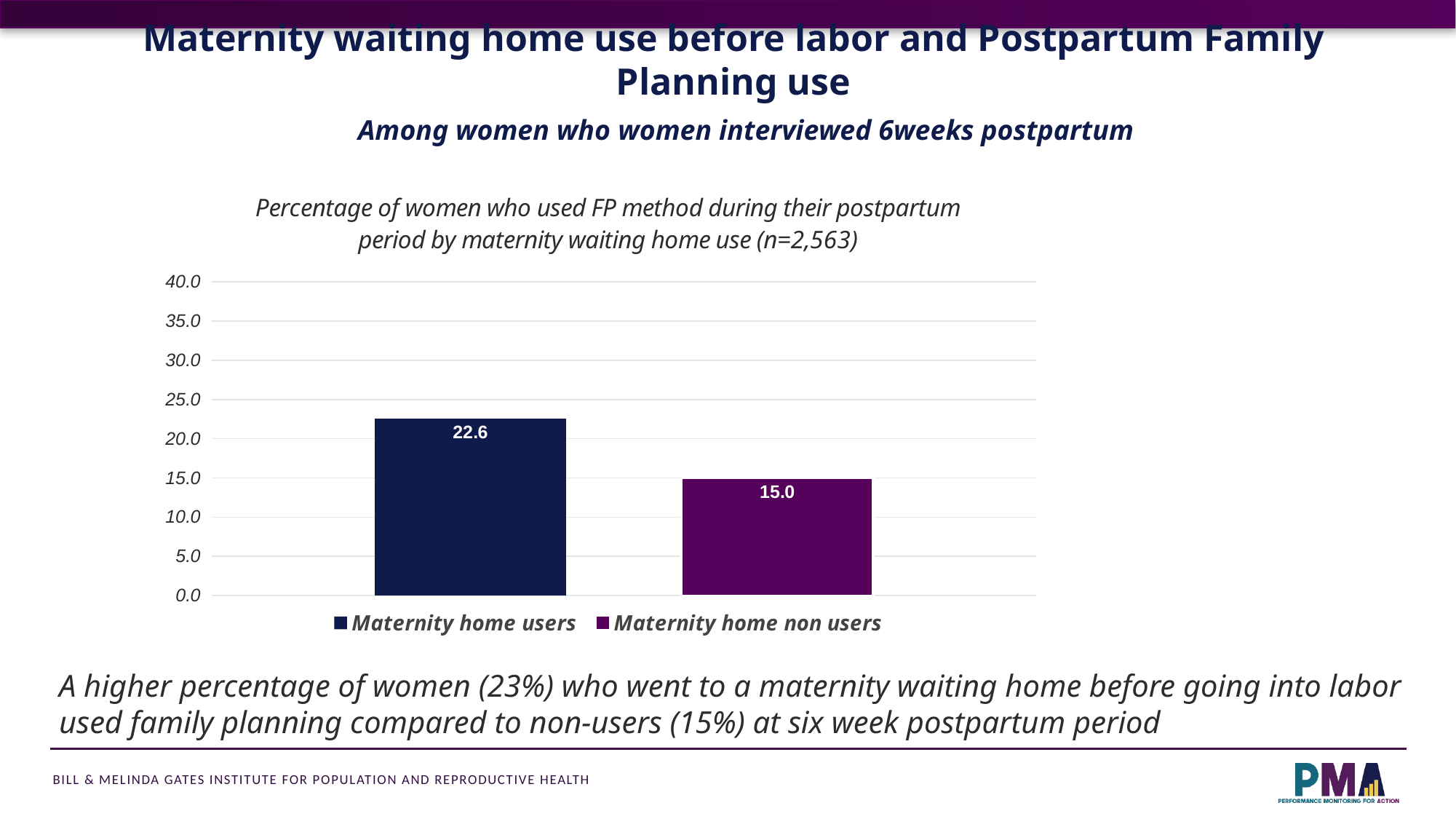
Which group has the lower percentage of postpartum FP use? Maternity home non users What is the sample size (n) given in the chart title? 2,563 Is the value for Maternity home users greater or less than 20.0? greater Is the value for Maternity home non users greater or less than 20.0? less Which group has the higher percentage of postpartum FP use? Maternity home users What kind of chart is shown on the slide? Bar chart What is the value for Maternity home users? 22.6 What is the difference between the values for Maternity home users and Maternity home non users? 7.6 How many entries does the legend list? 2 How many bars are plotted in the chart? 2 What is the value for Maternity home non users? 15.0 What is the highest value shown on the vertical axis? 40.0